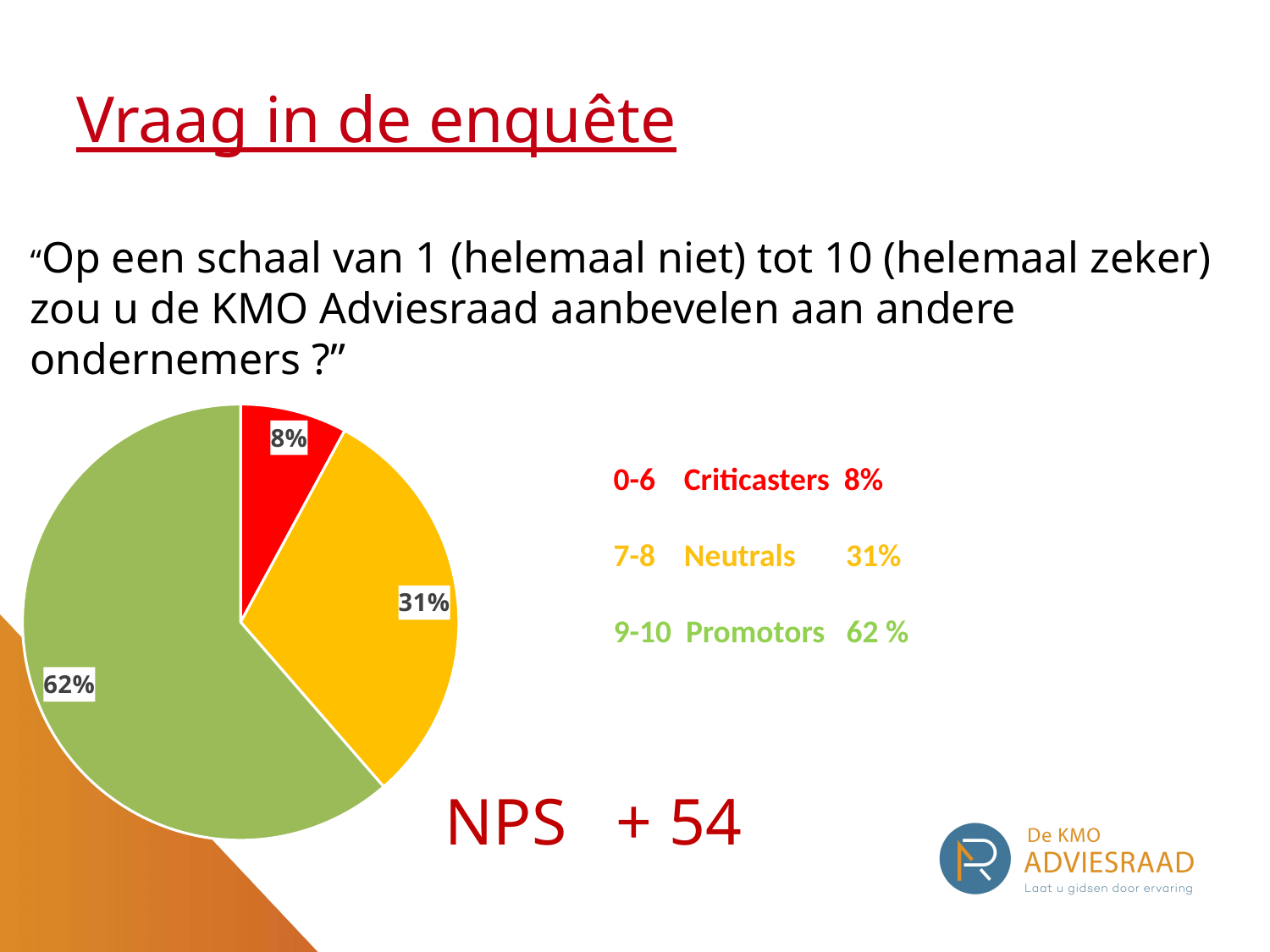
What share of the pie do the Neutrals (7-8) have? 31% What is the difference in percentage points between the Promotors and the Neutrals? 31 Which group has the largest slice of the pie? Promotors What NPS value is shown on the slide? + 54 What is the difference in percentage points between the Neutrals and the Criticasters? 23 What share of the pie do the Criticasters (0-6) have? 8% Which group has the smallest slice of the pie? Criticasters What kind of chart is shown on the slide? pie chart How many slices does the pie chart have? 3 Which slice is larger, Neutrals or Criticasters? Neutrals What colour is the Promotors slice of the pie? green What share of the pie do the Promotors (9-10) have? 62%